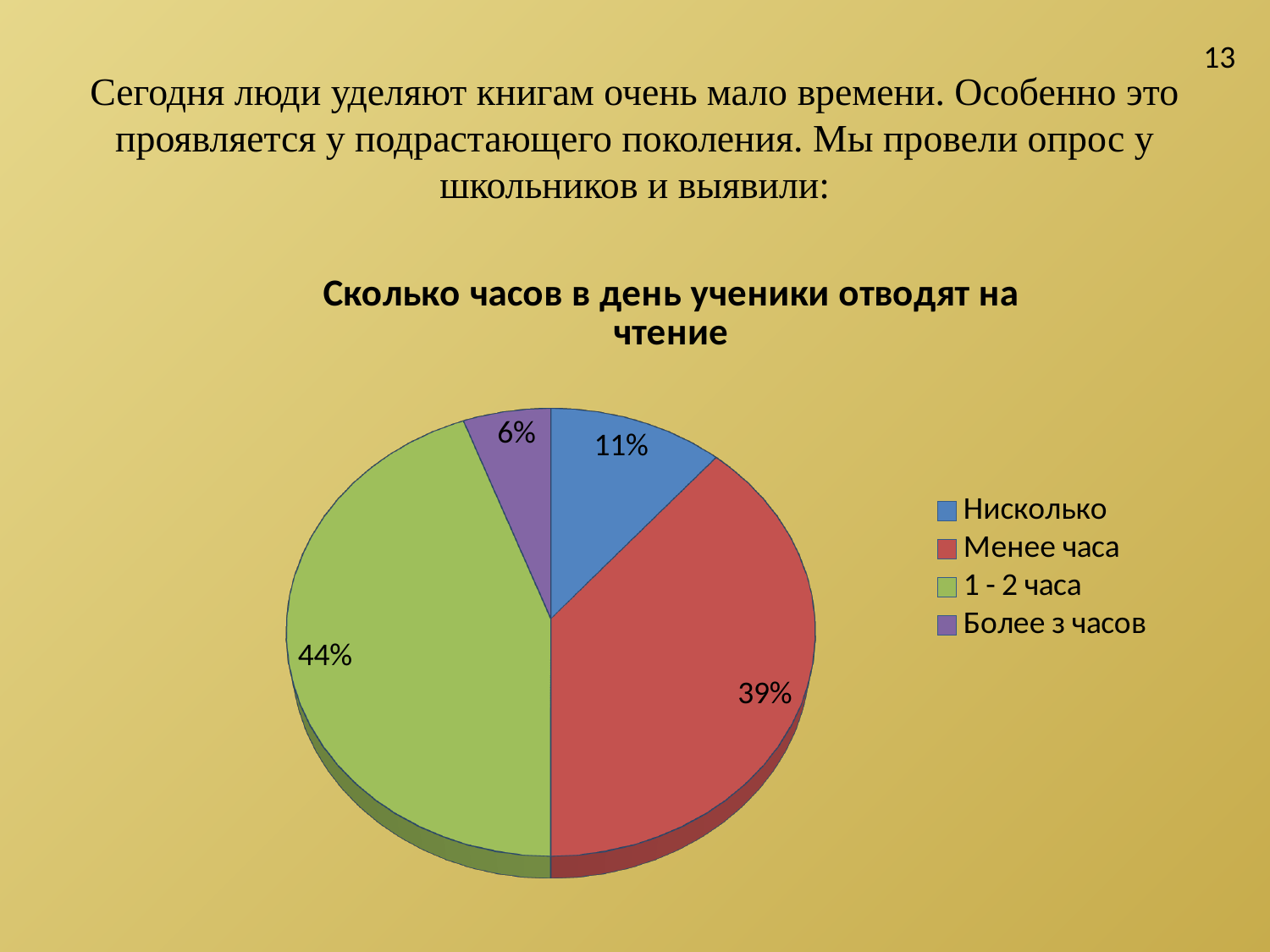
What is the value shown for "Менее часа"? 39% Which category has the smallest slice of the pie? Более з часов What is the difference between the "1 - 2 часа" and "Менее часа" slices? 5% What is the value shown for "Нисколько"? 11% What share of the pie does the "1 - 2 часа" slice represent? 44% What colour is the "Менее часа" slice? Red What kind of chart is shown on the slide? Pie chart What is the title of the chart? Сколько часов в день ученики отводят на чтение Which category has the largest slice of the pie? 1 - 2 часа What is the value shown for "Более з часов"? 6% Which is larger, the "Нисколько" slice or the "Более з часов" slice? Нисколько How many categories does the pie chart show? 4